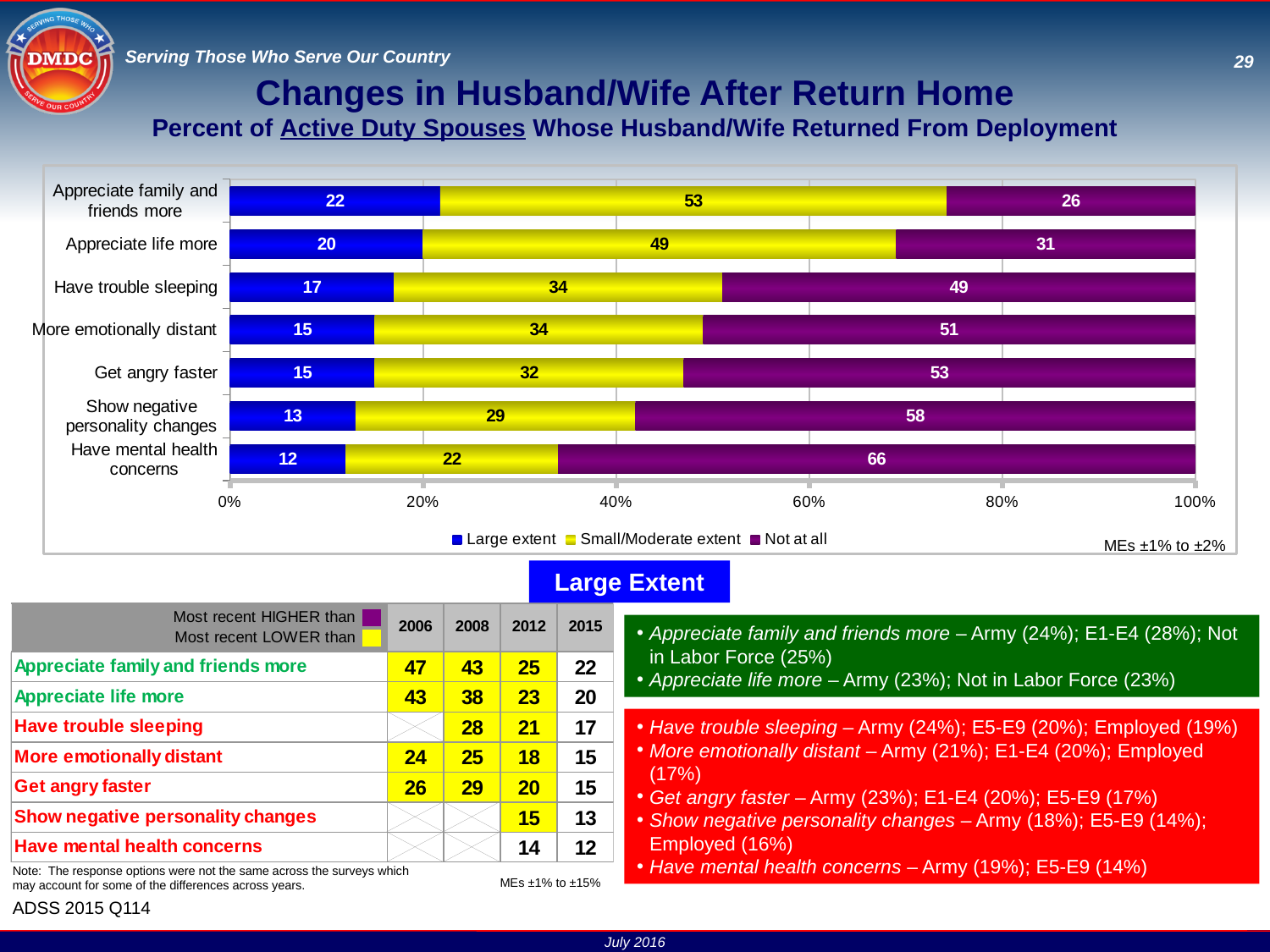
What is the difference between the 'Not at all' values for 'Have mental health concerns' and 'Appreciate family and friends more'? 40 What is the 'Large extent' value for 'Have trouble sleeping'? 17 What is the 'Not at all' value for 'Have mental health concerns'? 66 What kind of chart is shown on the slide? Stacked bar chart Which is larger: the 'Small/Moderate extent' value for 'Get angry faster' or for 'Show negative personality changes'? Get angry faster Which category has the lowest 'Not at all' value? Appreciate family and friends more How many categories are shown on the chart? 7 Which series is shown in blue in the legend? Large extent What is the total of the stacked bar for 'More emotionally distant'? 100 Which category has the highest 'Large extent' value? Appreciate family and friends more What is the 'Small/Moderate extent' value for 'Appreciate life more'? 49 How many series does the legend list? 3